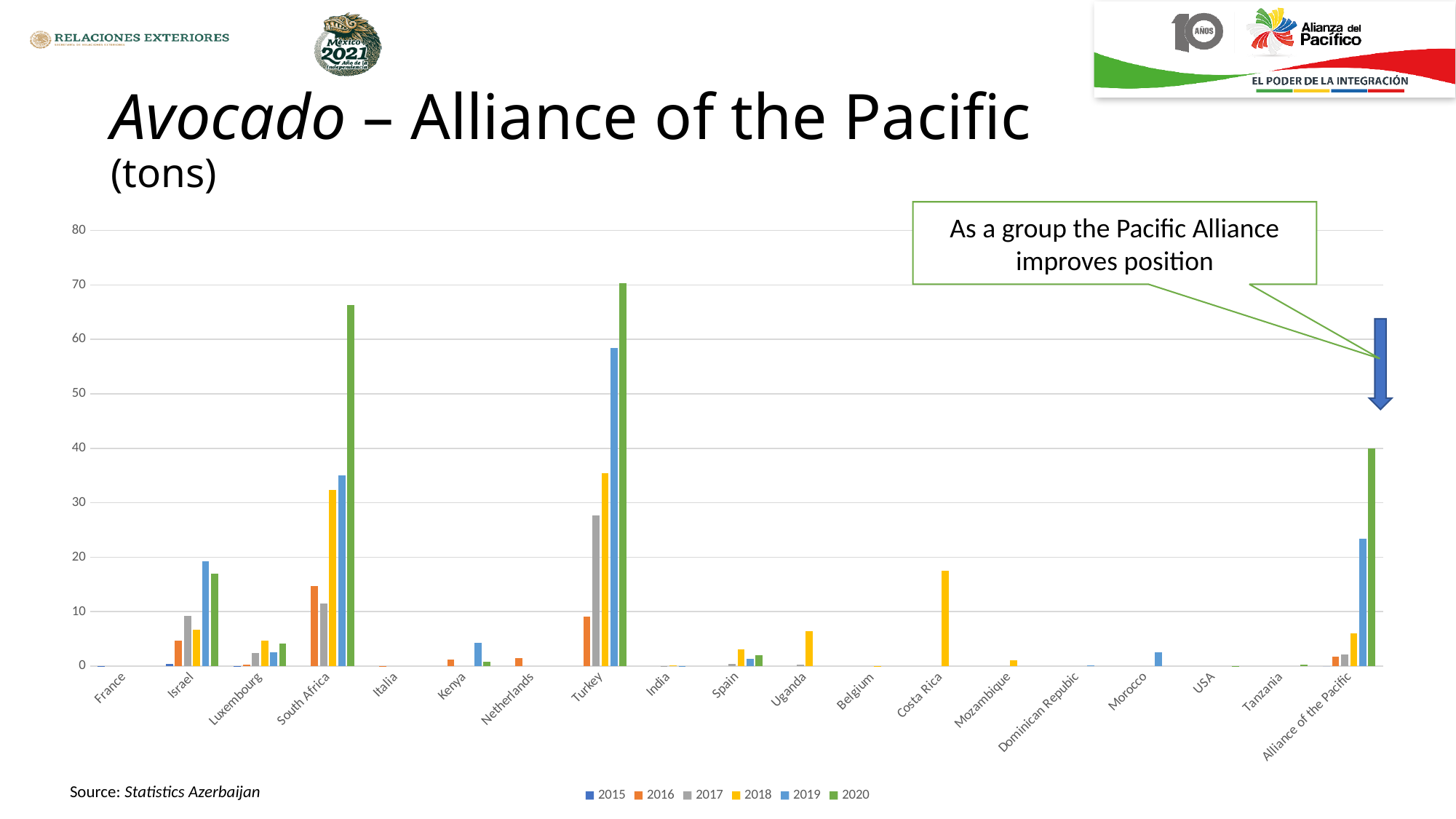
How many series does the legend list? 6 Which category has the tallest 2020 bar? Turkey Which is larger, the 2020 value for Alliance of the Pacific or the 2020 value for Israel? Alliance of the Pacific Is the 2019 value for Turkey greater or less than 50? greater What is the source cited for the chart? Statistics Azerbaijan How many categories are shown on the x axis? 19 Is the 2019 value for Alliance of the Pacific greater or less than 20? greater Do the values for Alliance of the Pacific rise or fall from 2015 to 2020? rise Which is larger, the 2019 value for Turkey or the 2019 value for South Africa? Turkey Is the 2018 value for Costa Rica greater or less than 20? less What kind of chart is shown on the slide? bar chart